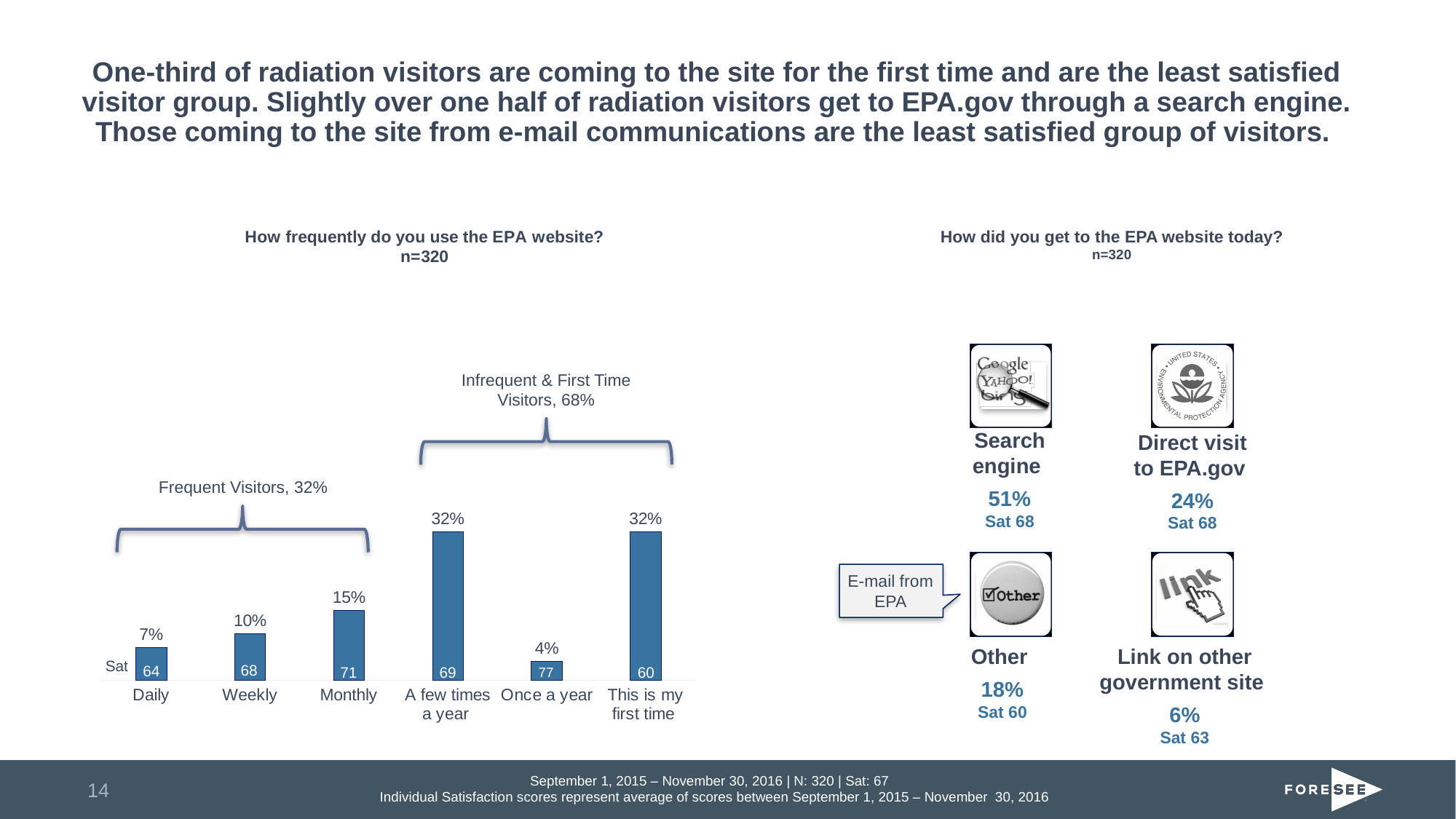
In the chart 'How frequently do you use the EPA website?', what is the satisfaction (Sat) score for 'Once a year' visitors? 77 In the chart 'How frequently do you use the EPA website?', which category has the lowest satisfaction (Sat) score? This is my first time In the chart 'How did you get to the EPA website today?', what percentage of visitors arrived via a Search engine? 51% In the chart 'How frequently do you use the EPA website?', how many frequency categories are shown? 6 In the chart 'How frequently do you use the EPA website?', what is the difference in percentage points between Monthly and Weekly? 5 In the chart 'How frequently do you use the EPA website?', what percentage of visitors say 'This is my first time'? 32% In the chart 'How frequently do you use the EPA website?', which category has the lowest percentage? Once a year In the chart 'How frequently do you use the EPA website?', which is larger, the percentage for Daily or for Monthly? Monthly In the chart 'How frequently do you use the EPA website?', what combined percentage is labelled for Frequent Visitors? 32% In the chart 'How did you get to the EPA website today?', what is the satisfaction (Sat) score for 'Link on other government site'? 63 In the chart 'How frequently do you use the EPA website?', what percentage of visitors use the site Monthly? 15% In the chart 'How frequently do you use the EPA website?', what kind of chart is used? bar chart